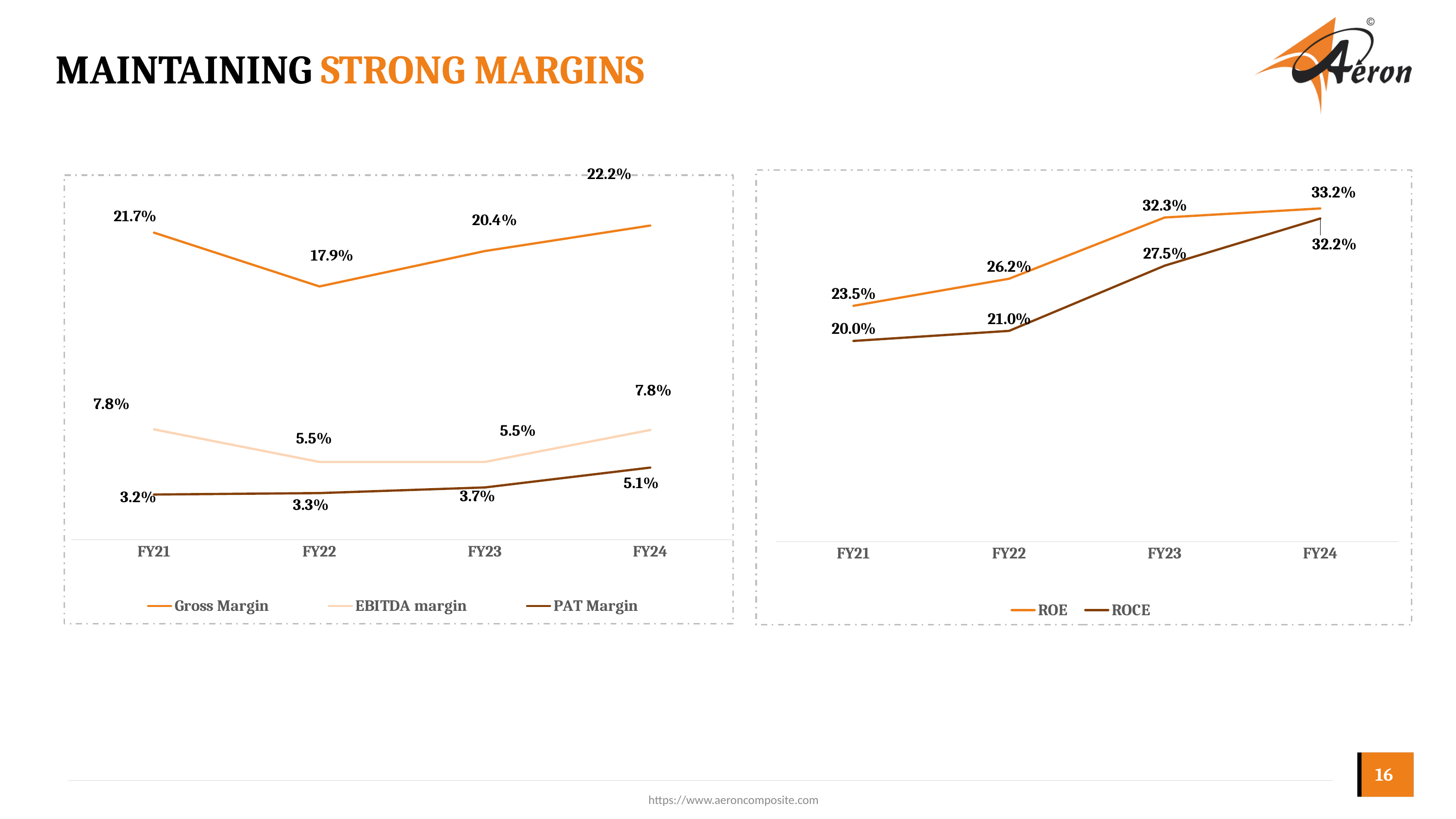
In the left chart, what is the difference between the Gross Margin in FY24 and FY21? 0.5% In the left chart, what is the PAT Margin for FY23? 3.7% How many series does the legend of the left chart list? 3 In the left chart, what is the Gross Margin for FY22? 17.9% In the right chart, is ROE or ROCE higher in FY23? ROE What kind of chart is the right chart? Line chart In the left chart, what is the EBITDA margin for FY24? 7.8% In the right chart, does ROCE rise or fall from FY21 to FY24? Rise In the right chart, which year has the highest ROE? FY24 In the left chart, which year has the lowest Gross Margin? FY22 In the right chart, what is the ROCE value for FY22? 21.0% In the right chart, what is the difference between ROE and ROCE in FY21? 3.5%